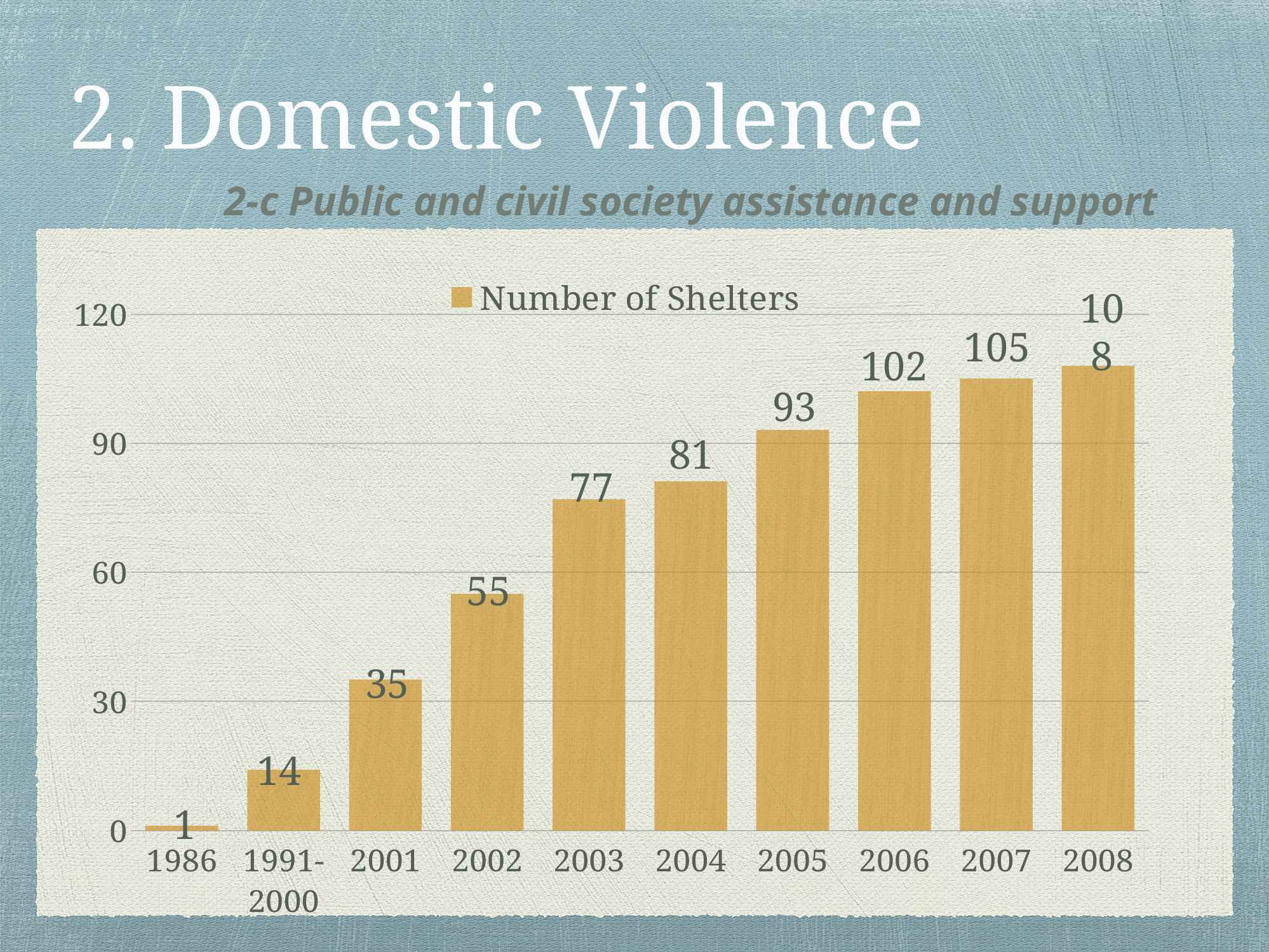
What is the number of shelters in 2002? 55 Which category has the highest number of shelters? 2008 How many categories are shown on the x axis? 10 What is the difference in the number of shelters between 2004 and 2003? 4 What is the number of shelters in 2005? 93 Which has more shelters, 2006 or 2005? 2006 Which category has the lowest number of shelters? 1986 What is the number of shelters in 1986? 1 Is the number of shelters in 2007 greater or less than 90? greater What is the number of shelters for 1991-2000? 14 Do the values rise or fall from 1986 to 2008? rise What kind of chart is shown on the slide? bar chart